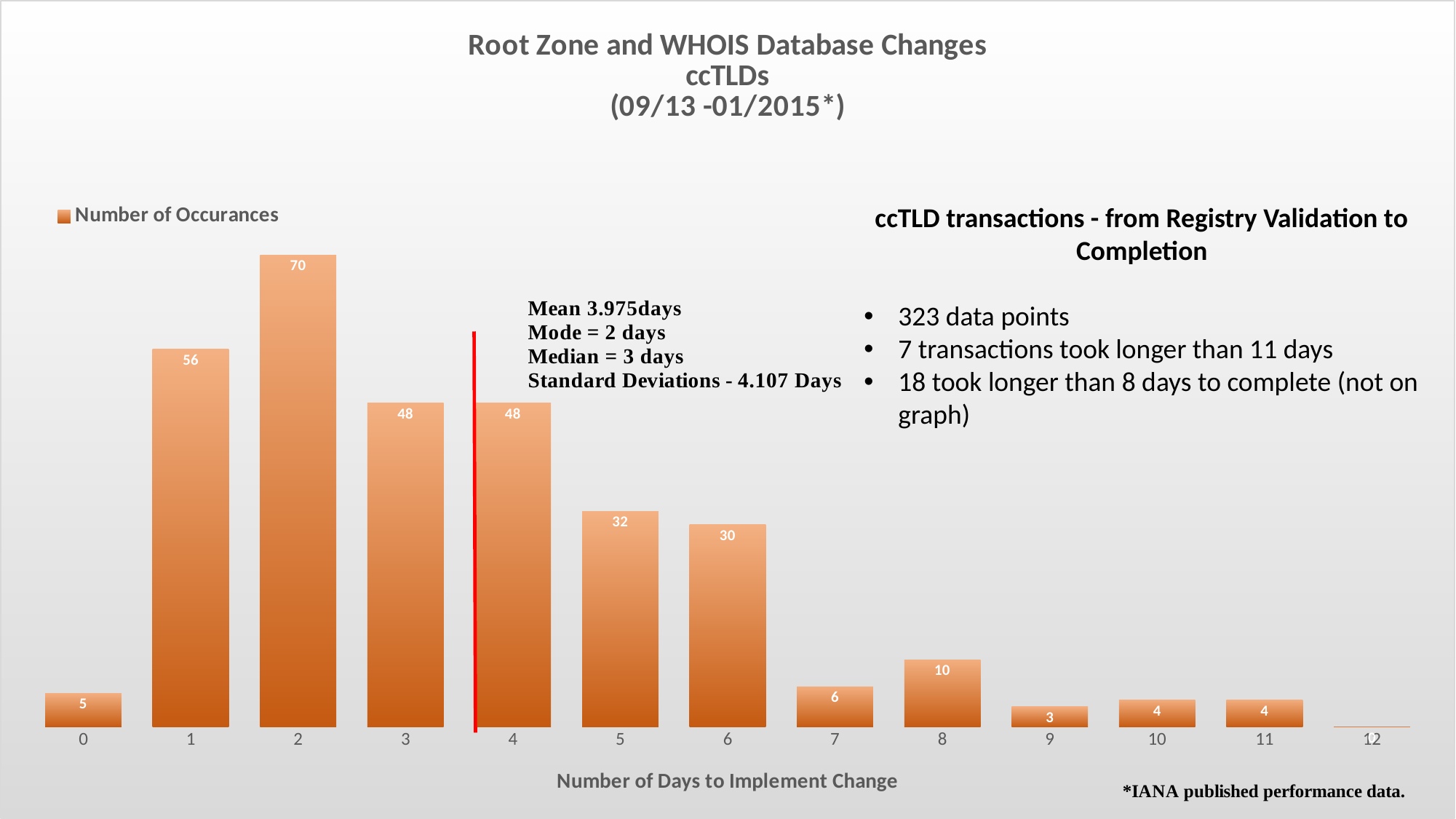
What is the number of occurrences for 5 days to implement change? 32 What is the x-axis title of the chart? Number of Days to Implement Change What series name does the legend show? Number of Occurances Which has more occurrences, 7 days or 8 days? 8 days What is the difference in occurrences between 2 days and 6 days? 40 What is the number of occurrences for 2 days to implement change? 70 What is the number of occurrences for 8 days to implement change? 10 What is the difference in occurrences between 1 day and 3 days? 8 Which number of days has the highest number of occurrences? 2 How many day categories are shown on the x axis? 13 Which has more occurrences, 5 days or 6 days? 5 days What kind of chart is shown on the slide? bar chart